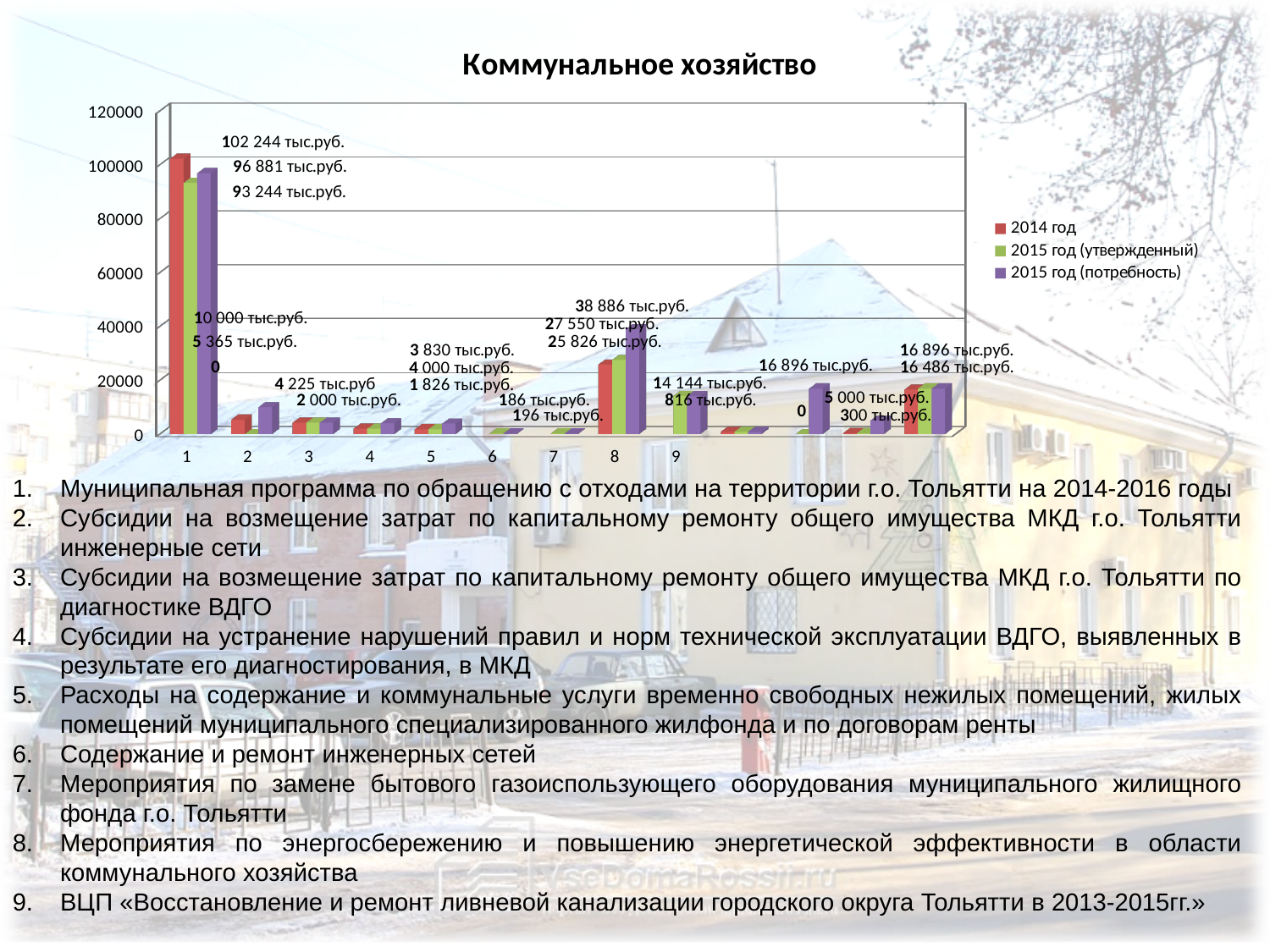
Which category has taller bars: category 1 or category 8? 1 Is the 2014 год value for category 1 greater or less than 100000? greater How many series does the chart legend list? 3 What is the difference between the largest and smallest labelled values for category 1 (102 244 and 93 244 тыс.руб.)? 9 000 тыс.руб. What is the value for category 1 in the 2014 год series? 102 244 тыс.руб. Which category has the highest bar in the chart? 1 Are the bars for category 8 greater or less than 40000? less What is the title of the chart? Коммунальное хозяйство What kind of chart is shown on the slide? bar chart Which series is shown in red in the chart legend? 2014 год What is the largest value labelled on the chart? 102 244 тыс.руб. For category 1, which is larger: the 2014 год bar or the 2015 год (потребность) bar? 2014 год